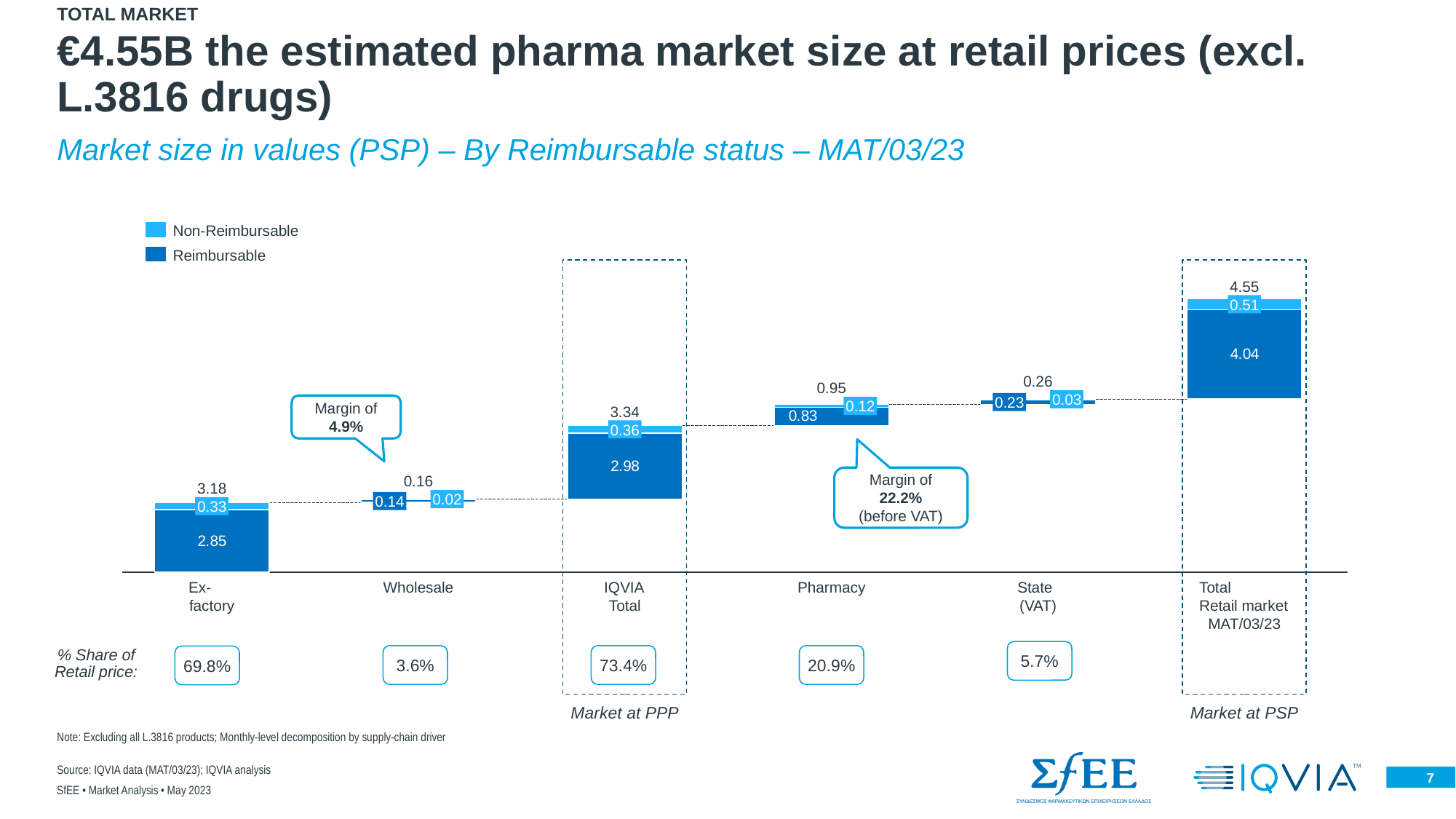
How many series does the legend list? 2 What is the % Share of Retail price shown for Pharmacy? 20.9% What is the difference between the Reimbursable values for IQVIA Total and Ex-factory? 0.13 What is the Non-Reimbursable value for Pharmacy? 0.12 What is the total value shown above the Total Retail market MAT/03/23 bar? 4.55 What is the Reimbursable value for Ex-factory? 2.85 Which category has the lowest total value? Wholesale How many categories are shown along the x axis? 6 What is the total value shown above the Wholesale bar? 0.16 Which is larger, the Non-Reimbursable value for Pharmacy or for State (VAT)? Pharmacy What kind of chart is shown on the slide? Stacked bar chart (waterfall) Which category has the highest total value? Total Retail market MAT/03/23